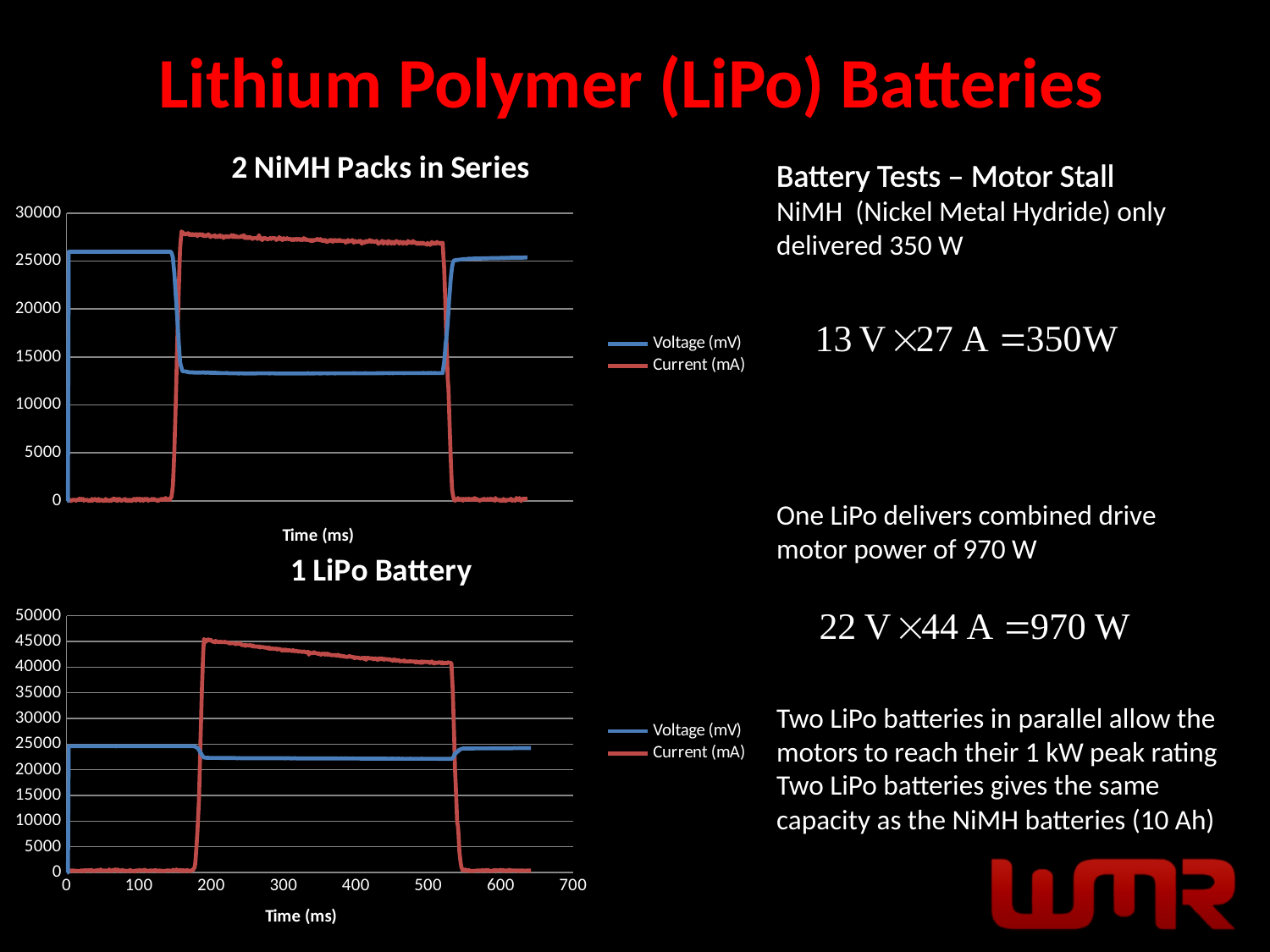
In the '1 LiPo Battery' chart, is the Voltage (mV) value during the stall (around 400 ms) greater or less than 25000? less In the '1 LiPo Battery' chart, which series has the higher value at around 100 ms, Voltage (mV) or Current (mA)? Voltage (mV) In the '2 NiMH Packs in Series' chart, which series has the higher value at around 300 ms, Voltage (mV) or Current (mA)? Current (mA) What kind of chart is the '2 NiMH Packs in Series' chart? line chart In the '1 LiPo Battery' chart, does the Current (mA) series rise or fall between 200 ms and 500 ms? fall In the '2 NiMH Packs in Series' chart, is the Voltage (mV) value during the stall (around 300 ms) greater or less than 15000? less In the '1 LiPo Battery' chart, is the peak Current (mA) value (around 200 ms) greater or less than 40000? greater What is the x-axis title of the '1 LiPo Battery' chart? Time (ms) What is the highest value shown on the y-axis of the '1 LiPo Battery' chart? 50000 What are the two series named in the legend of the '2 NiMH Packs in Series' chart? Voltage (mV) and Current (mA) How many series does the legend of the '1 LiPo Battery' chart list? 2